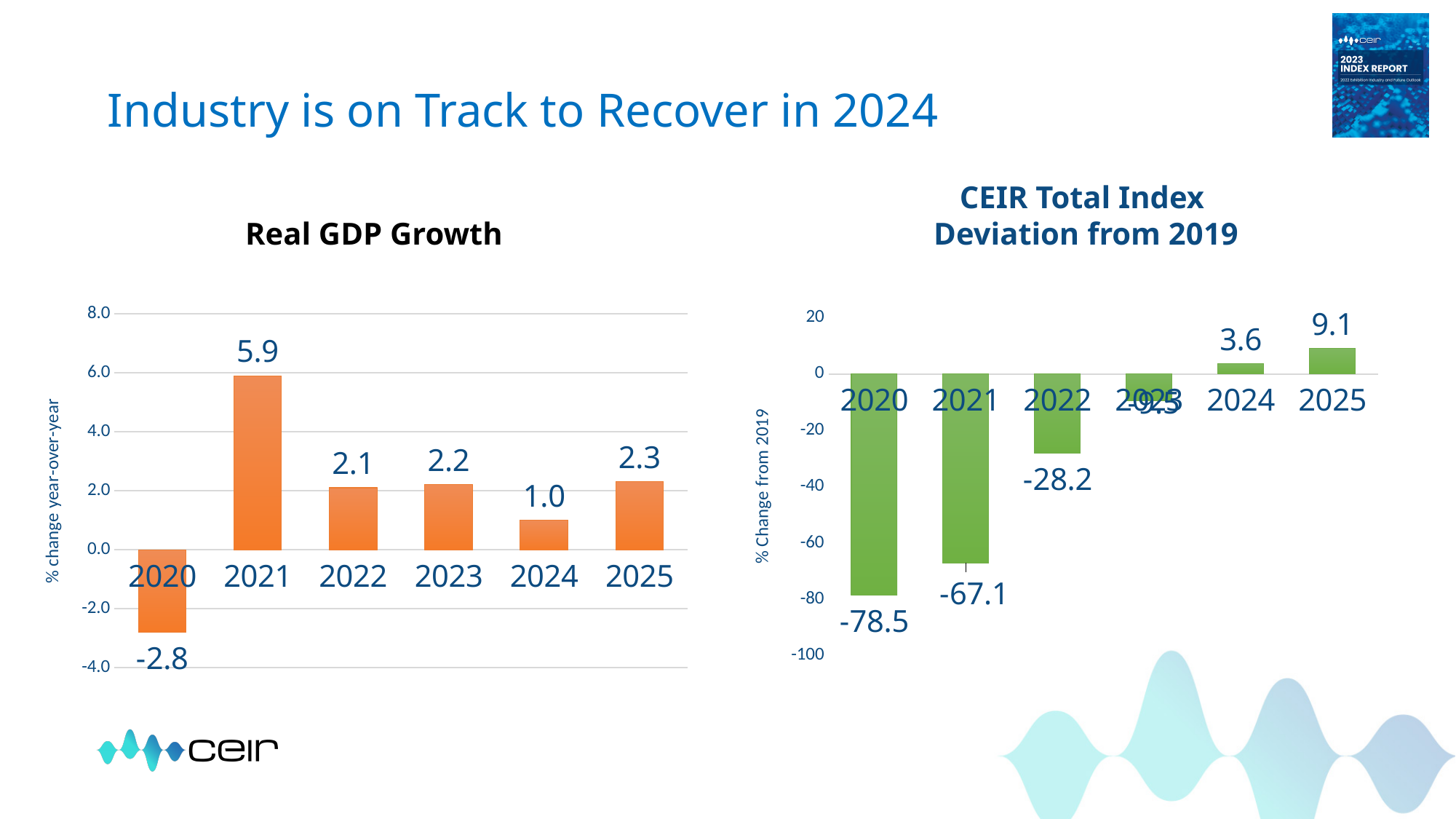
In the Real GDP Growth chart, which year has the lowest value? 2020 In the CEIR Total Index Deviation from 2019 chart, do the values rise or fall from 2020 to 2025? rise In the Real GDP Growth chart, what is the value for 2020? -2.8 In the CEIR Total Index Deviation from 2019 chart, which year has the lowest value? 2020 In the Real GDP Growth chart, what is the difference between the values for 2021 and 2024? 4.9 What kind of chart is the Real GDP Growth chart? bar chart In the Real GDP Growth chart, how many years are shown on the x axis? 6 In the Real GDP Growth chart, what is the value for 2021? 5.9 In the Real GDP Growth chart, which year has the highest value? 2021 In the CEIR Total Index Deviation from 2019 chart, what is the difference between the values for 2021 and 2022? 38.9 In the CEIR Total Index Deviation from 2019 chart, what is the value for 2025? 9.1 In the CEIR Total Index Deviation from 2019 chart, what is the value for 2020? -78.5